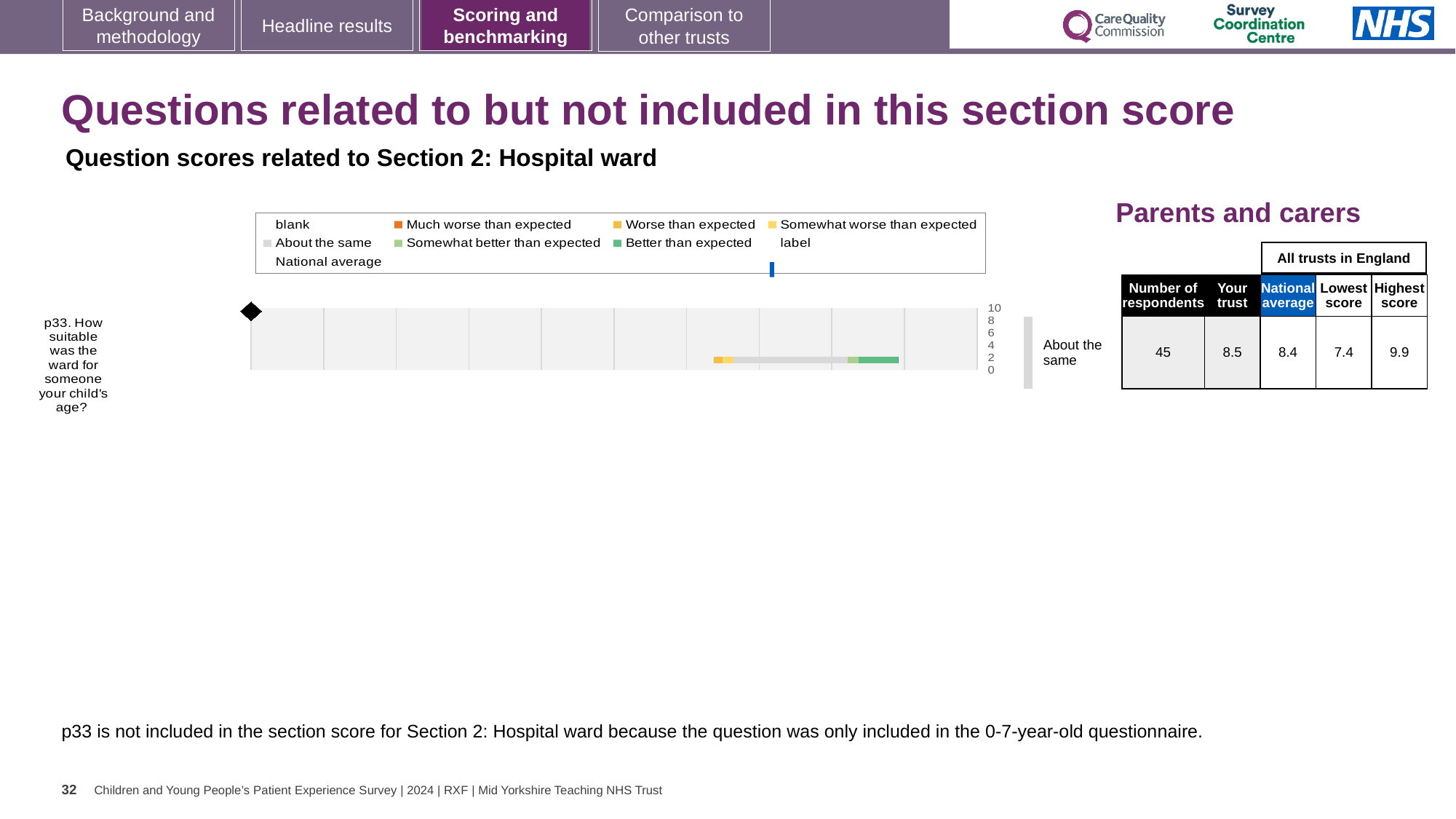
What is the national average score for p33? 8.4 Is the 'Your trust' score for p33 greater or less than 8 on the chart's axis? greater What is the difference between the highest score and the lowest score for p33? 2.5 What is the 'Your trust' score for p33? 8.5 How many respondents answered p33? 45 What kind of chart is shown on the slide? bar chart Which is larger for p33, the 'Your trust' score or the national average? Your trust What is the lowest score among all trusts in England for p33? 7.4 How many questions (categories) are plotted in the chart? 1 What benchmark category is shown next to the bar for p33? About the same What is the highest score among all trusts in England for p33? 9.9 Which question is plotted in the chart? p33. How suitable was the ward for someone your child's age?